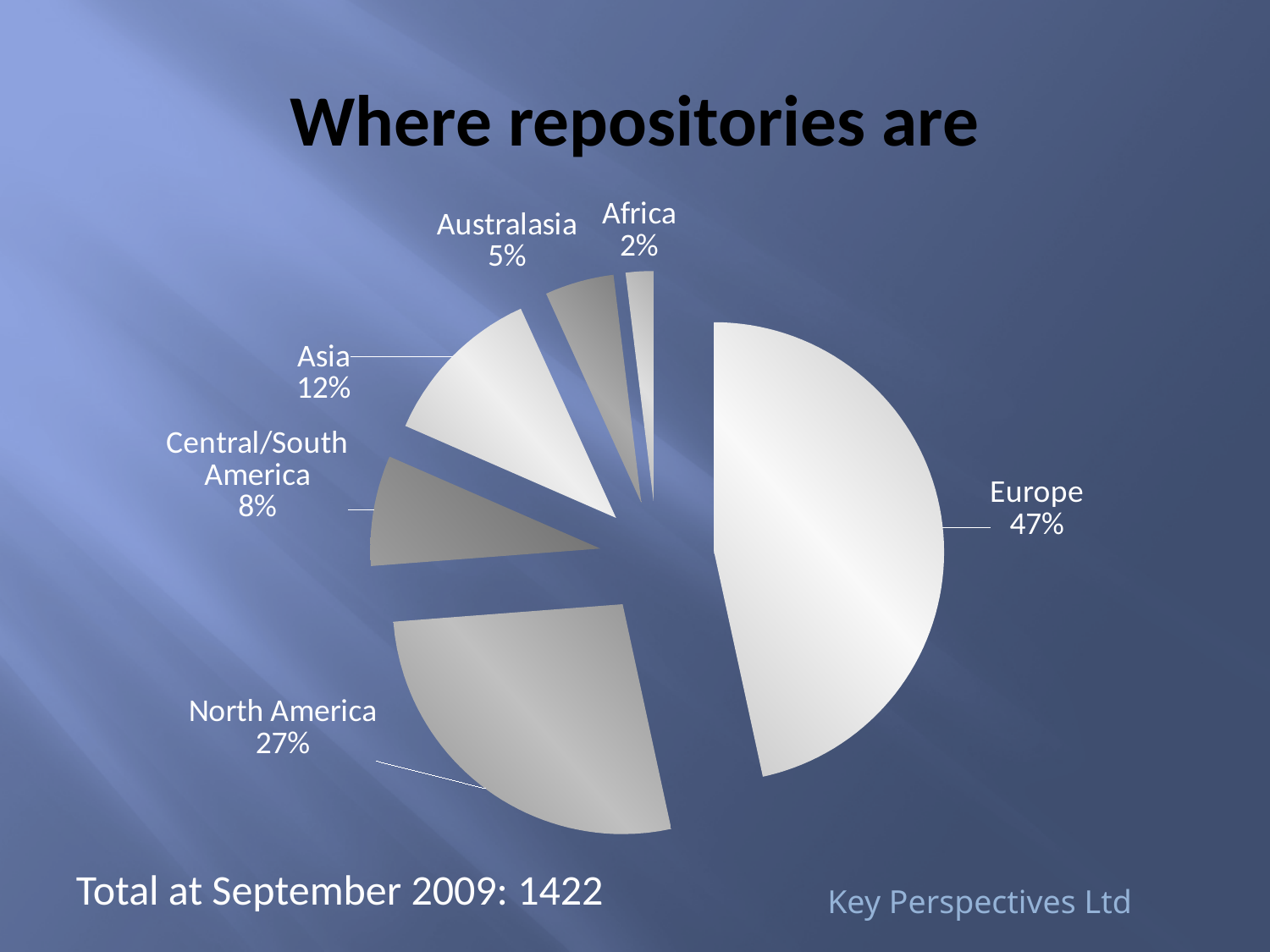
What share of repositories is in Europe? 47% What share of repositories is in North America? 27% What is the difference in percentage points between Europe's share and North America's share? 20 Which region has the largest share of repositories? Europe Which region has the smallest share of repositories? Africa How many regions are shown in the pie chart? 6 What share of repositories is in Asia? 12% What share of repositories is in Central/South America? 8% What is the title of the chart? Where repositories are What share of repositories is in Australasia? 5% Which has a larger share of repositories, Asia or Central/South America? Asia What kind of chart is shown on the slide? Pie chart